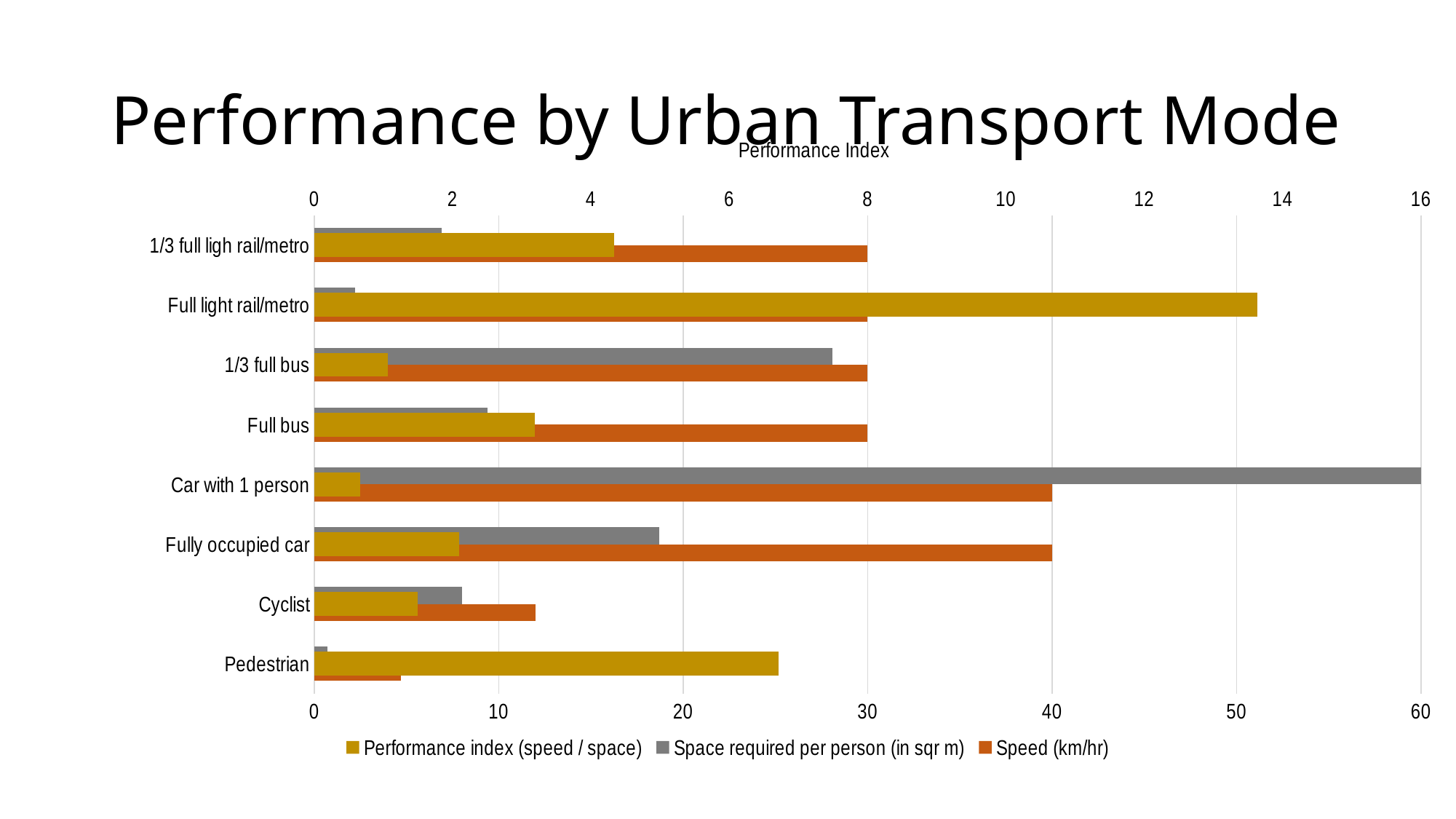
What is the difference in Speed (km/hr) between Car with 1 person and Full bus? 10 What is the Speed (km/hr) value for Full bus? 30 Which has the larger Speed (km/hr) value, Cyclist or Pedestrian? Cyclist What is the Space required per person (in sqr m) for Car with 1 person? 60 Is the Speed (km/hr) value for Cyclist greater or less than 20? less What kind of chart is shown on the slide? Bar chart How many series does the legend list? 3 Which transport mode has the highest Performance index (speed / space)? Full light rail/metro What is the Speed (km/hr) value for Car with 1 person? 40 Which transport mode has the highest Space required per person? Car with 1 person How many transport modes (categories) are plotted on the chart? 8 Which transport mode has the lowest Space required per person? Pedestrian